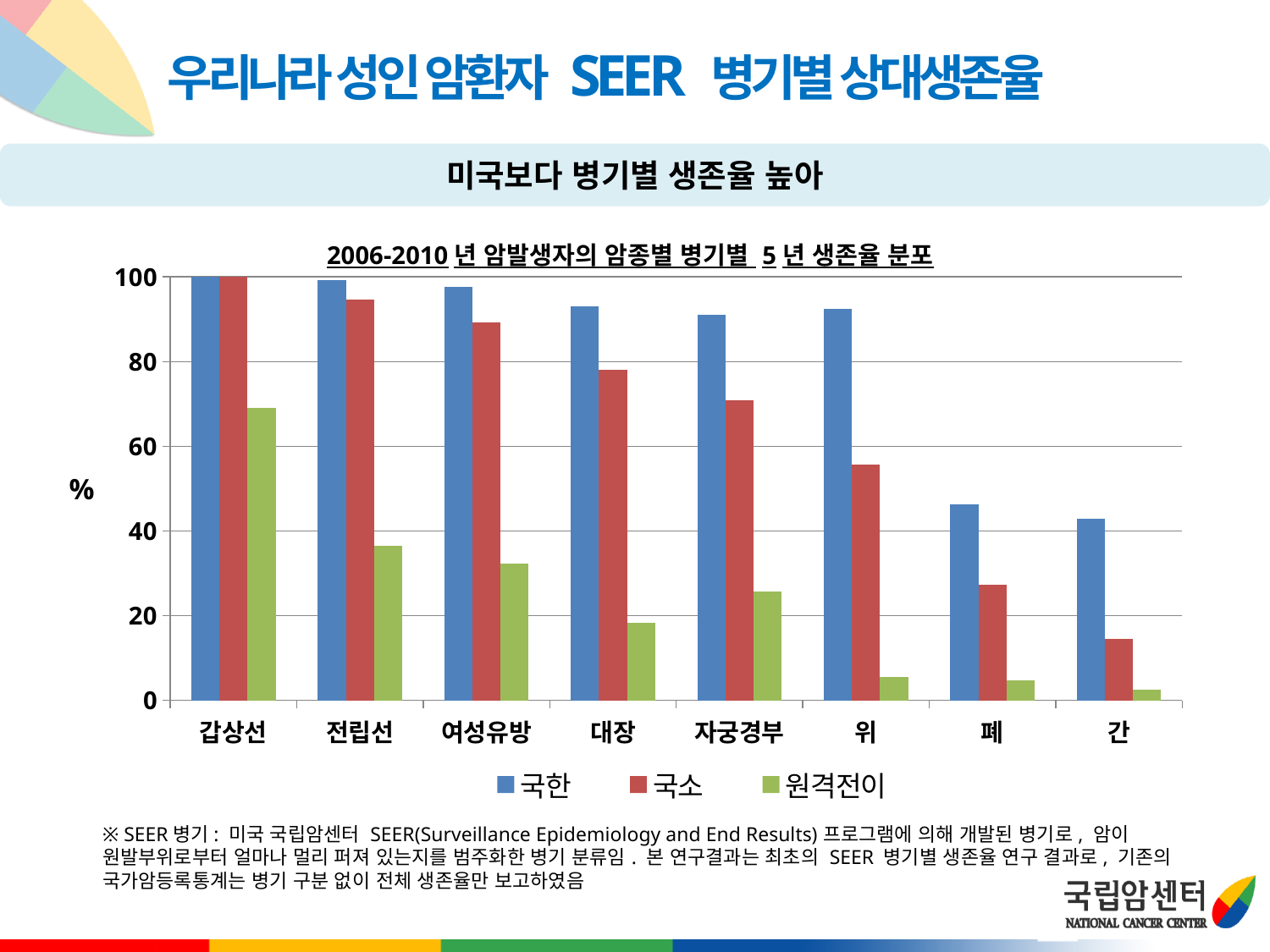
What is the title of the chart? 2006-2010 년 암발생자의 암종별 병기별 5 년 생존율 분포 What are the three series listed in the chart legend? 국한, 국소, 원격전이 Which cancer type has the highest 원격전이 value? 갑상선 Do the 국한 values generally rise or fall moving from 갑상선 to 간 along the x axis? fall Is the 국소 value for 위 greater or less than 60? less What kind of chart is shown on the slide? bar chart Which cancer type has the lowest 원격전이 value? 간 Is the 국한 value for 폐 greater or less than 40? greater Which cancer type has the lowest 국한 value? 간 Which is larger, the 국소 value for 대장 or the 국소 value for 자궁경부? 대장 How many cancer types (categories) are shown on the x axis of the chart? 8 How many series does the chart legend list? 3